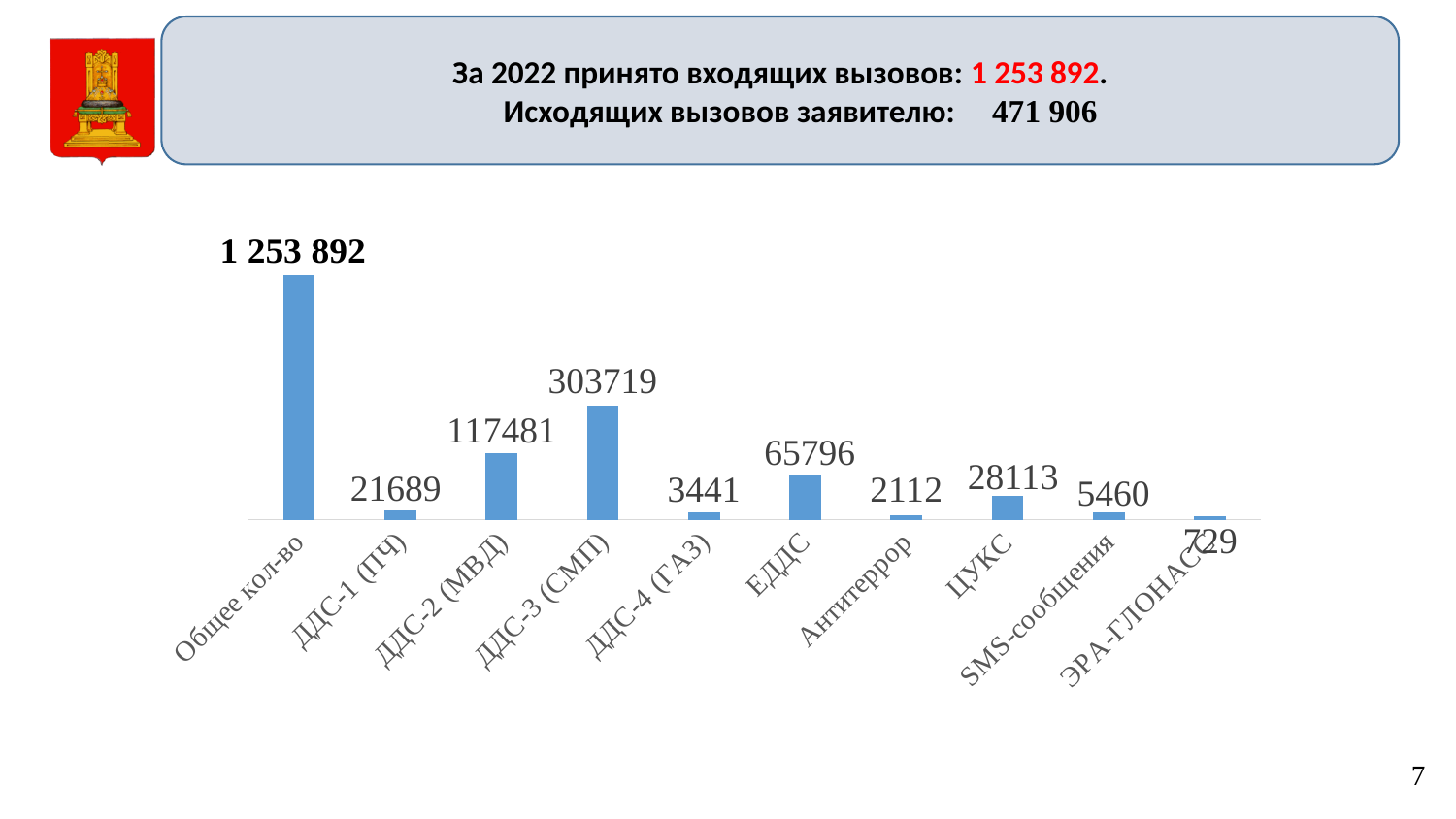
Which category has the highest value? Общее кол-во How many categories are plotted in the chart? 10 What is the value for ЭРА-ГЛОНАСС? 729 What is the value for ЕДДС? 65796 What is the difference between the values for ДДС-3 (СМП) and ДДС-2 (МВД)? 186238 What type of chart is shown on the slide? bar chart What is the value for ДДС-2 (МВД)? 117481 What is the value for ДДС-3 (СМП)? 303719 Which category has the lowest value? ЭРА-ГЛОНАСС What is the difference between the values for SMS-сообщения and ДДС-4 (ГАЗ)? 2019 Which is larger, the value for ЦУКС or the value for ДДС-1 (ПЧ)? ЦУКС What is the value for Антитеррор? 2112